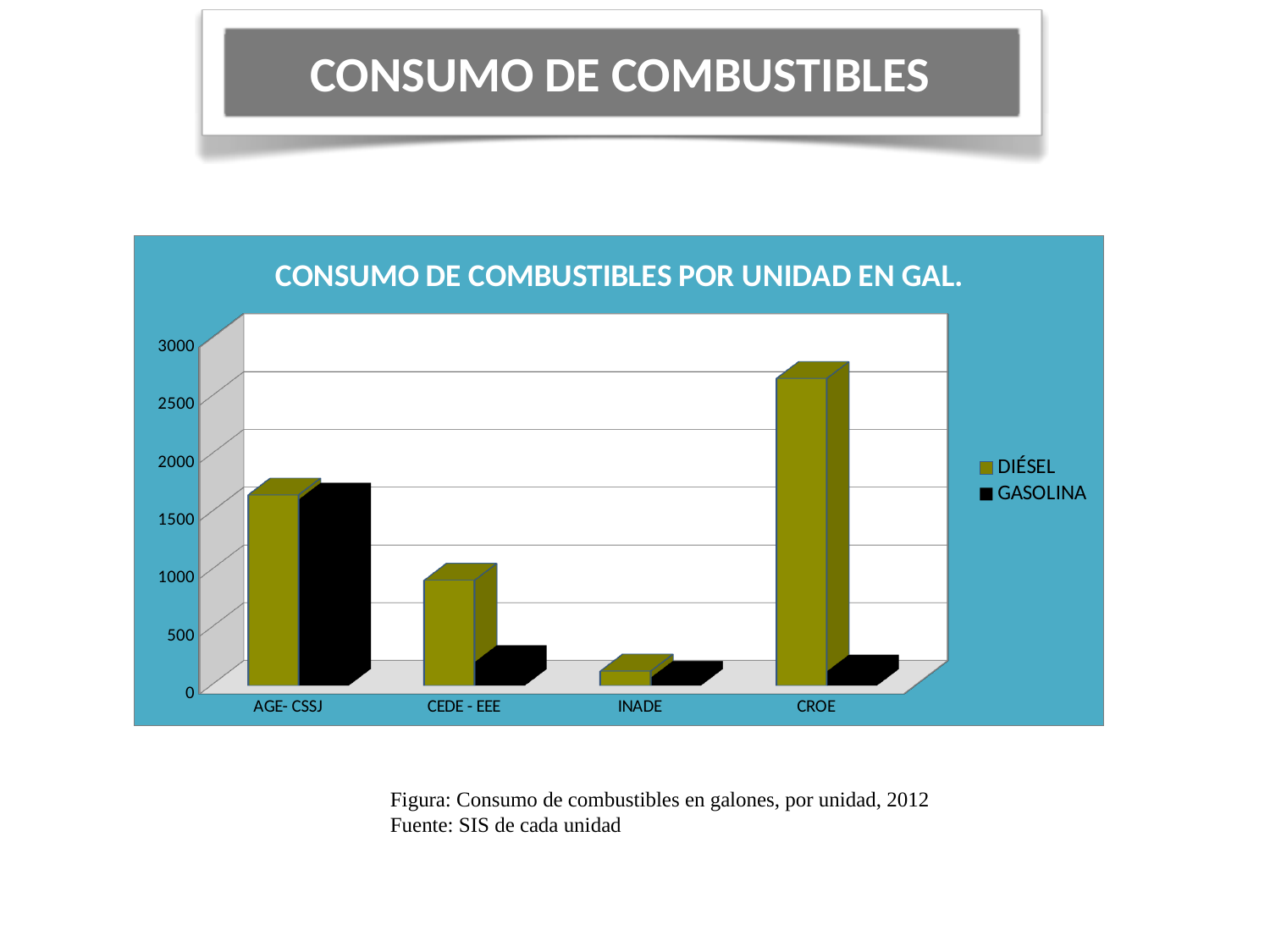
Which unit has the lowest GASOLINA consumption? INADE Which unit has the lowest DIÉSEL consumption? INADE For CEDE - EEE, which is larger, the DIÉSEL value or the GASOLINA value? DIÉSEL Is the DIÉSEL value for CROE greater or less than 2500? greater What kind of chart is shown on the slide? bar chart Which unit has the highest DIÉSEL consumption? CROE Is the GASOLINA value for CEDE - EEE greater or less than 500? less How many units (categories) are shown on the x axis of the chart? 4 Is the DIÉSEL value for CEDE - EEE greater or less than 1000? less How many series does the chart legend list? 2 What is the title of the chart? CONSUMO DE COMBUSTIBLES POR UNIDAD EN GAL. Which unit has the highest GASOLINA consumption? AGE- CSSJ